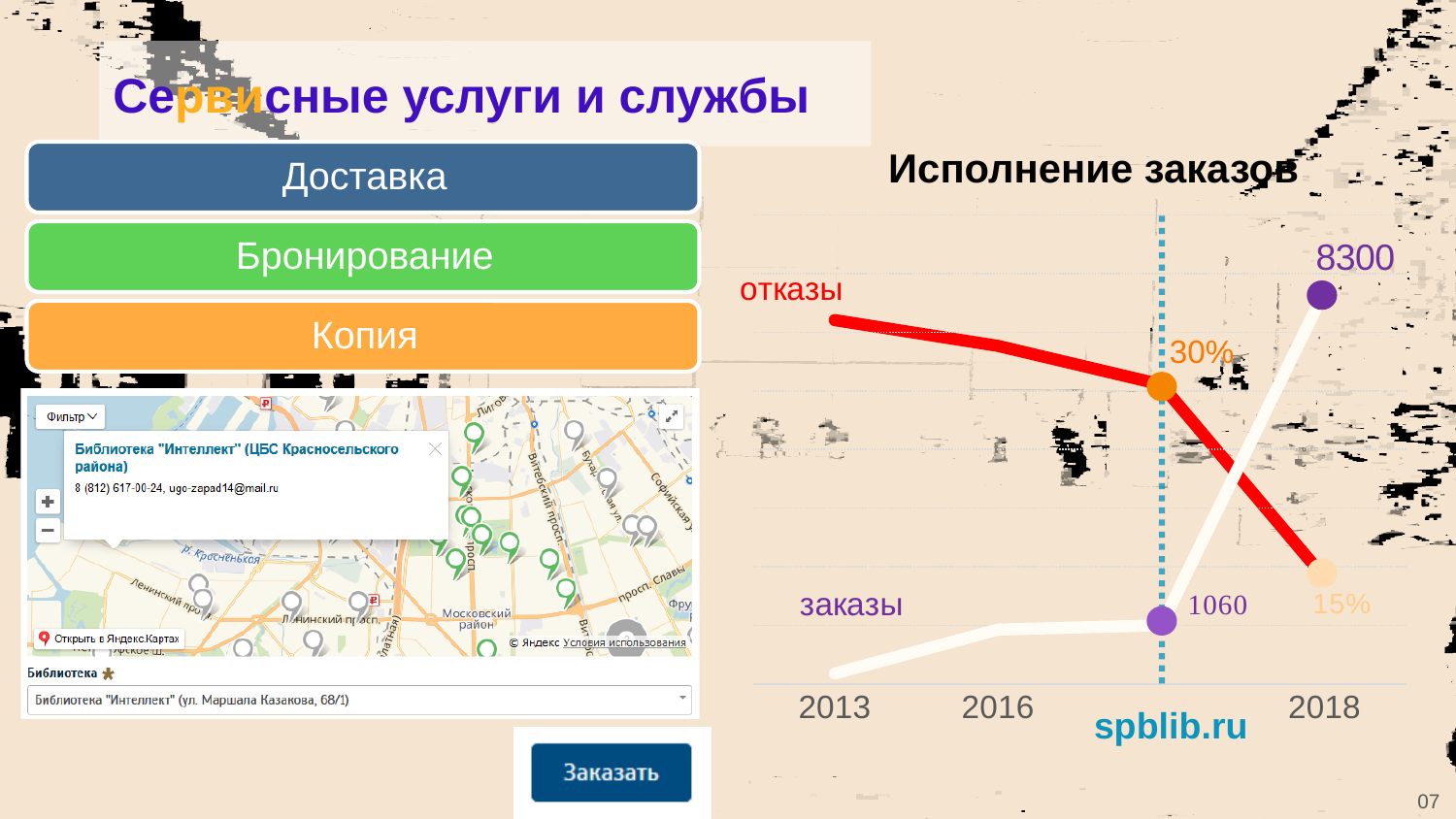
In the "Исполнение заказов" chart, which series is drawn in red? отказы In the "Исполнение заказов" chart, by how much does the "заказы" value at 2018 (8300) exceed the value at the dashed line (1060)? 7240 How many years are labeled on the x axis of the "Исполнение заказов" chart? 3 In the "Исполнение заказов" chart, what value is labeled at the 2018 point of the "заказы" line? 8300 How many data series are plotted in the "Исполнение заказов" chart? 2 In the "Исполнение заказов" chart, what value is labeled at the 2018 end of the "отказы" line? 15% What is the title of the chart on the right side of the slide? Исполнение заказов What kind of chart is shown under the title "Исполнение заказов"? line chart In the "Исполнение заказов" chart, what value is labeled on the orange point of the "отказы" line at the dashed vertical line? 30% In the "Исполнение заказов" chart, does the "отказы" line rise or fall from 2013 to 2018? fall In the "Исполнение заказов" chart, what value is labeled on the purple point of the "заказы" line at the dashed vertical line? 1060 In the "Исполнение заказов" chart, does the "заказы" line rise or fall from 2013 to 2018? rise